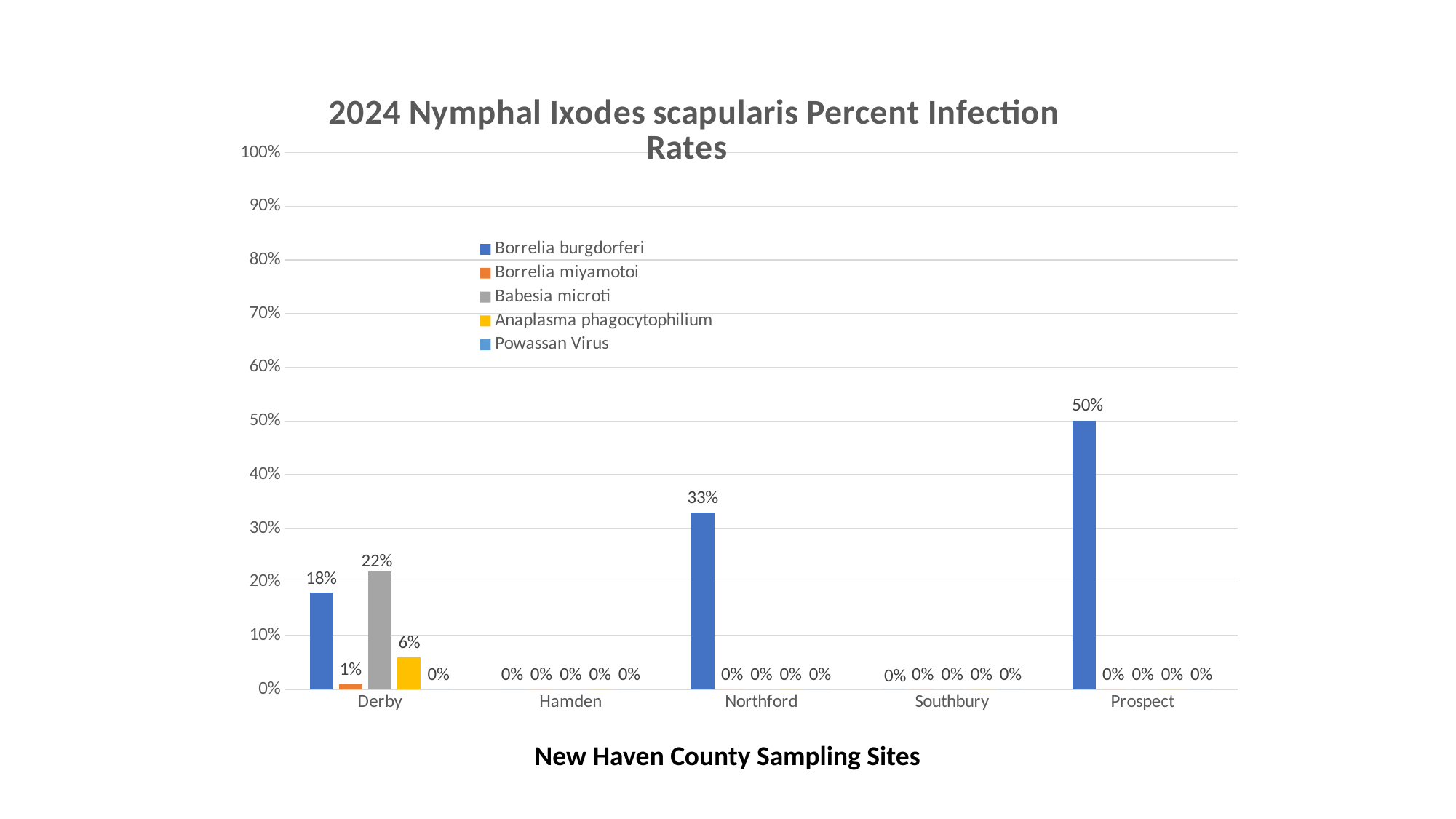
What is the Borrelia burgdorferi infection rate at Prospect? 50% How many sampling sites are shown on the x axis? 5 Which sampling site has the highest Borrelia burgdorferi infection rate? Prospect What kind of chart is shown on the slide? Bar chart Which is larger at Derby: the Borrelia burgdorferi rate or the Babesia microti rate? Babesia microti What is the Anaplasma phagocytophilium infection rate at Derby? 6% What is the difference between the Borrelia burgdorferi infection rates at Prospect and Northford? 17% What is the Borrelia burgdorferi infection rate at Northford? 33% What is the Babesia microti infection rate at Derby? 22% What is the x-axis title of the chart? New Haven County Sampling Sites How many series does the legend list? 5 What is the Borrelia miyamotoi infection rate at Derby? 1%